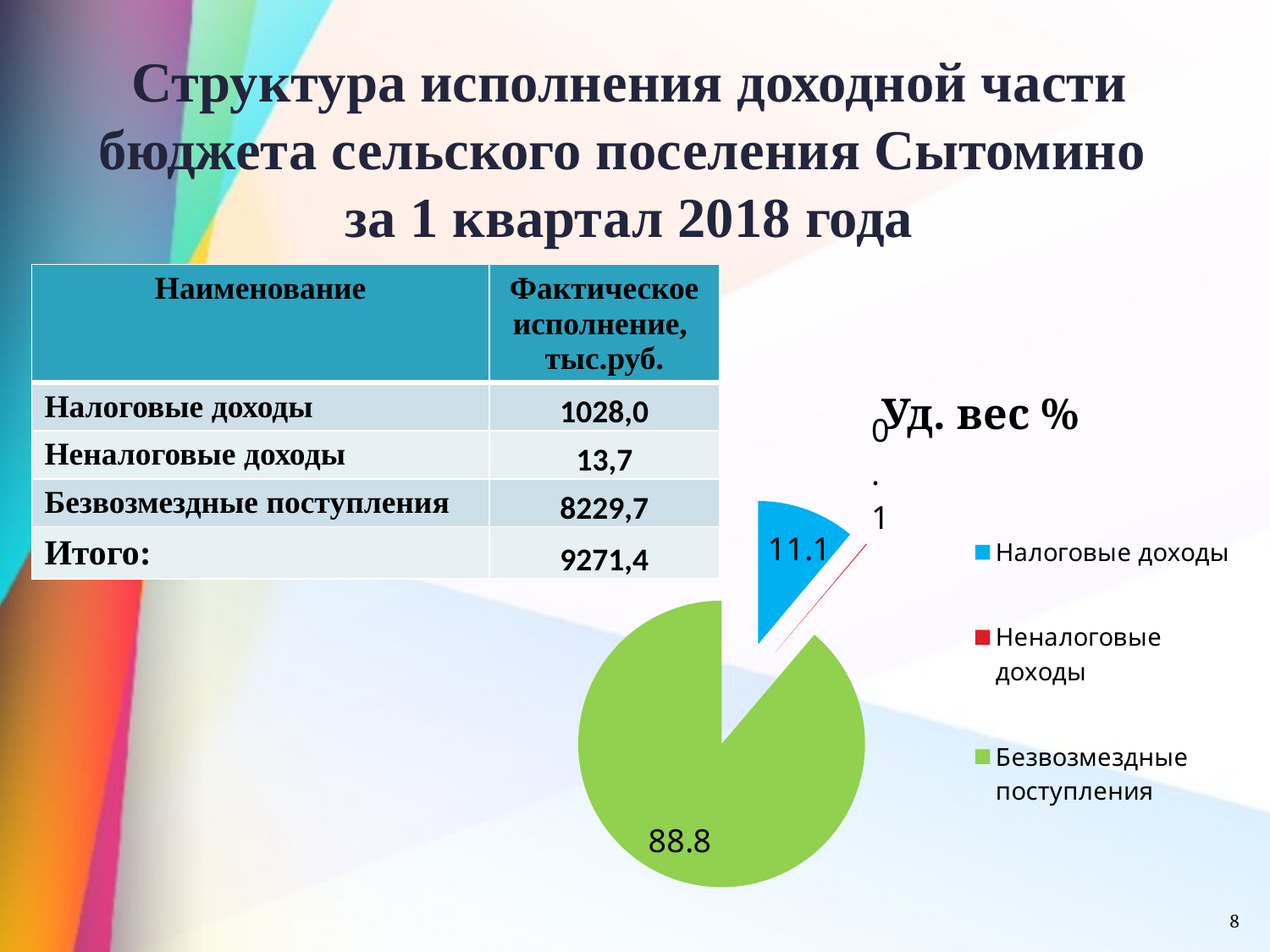
How many entries does the legend of the pie chart list? 3 What kind of chart is shown on the slide? pie chart What colour is the slice for Безвозмездные поступления in the pie chart? green Which category has the largest slice in the pie chart? Безвозмездные поступления What is the value shown for Безвозмездные поступления in the pie chart? 88.8 How many slices does the pie chart have? 3 What is the title of the pie chart? Уд. вес % What is the value shown for Неналоговые доходы in the pie chart? 0.1 What is the difference between the values for Безвозмездные поступления and Налоговые доходы in the pie chart? 77.7 What is the value shown for Налоговые доходы in the pie chart? 11.1 Which category has the smallest slice in the pie chart? Неналоговые доходы Which is larger in the pie chart, Налоговые доходы or Неналоговые доходы? Налоговые доходы